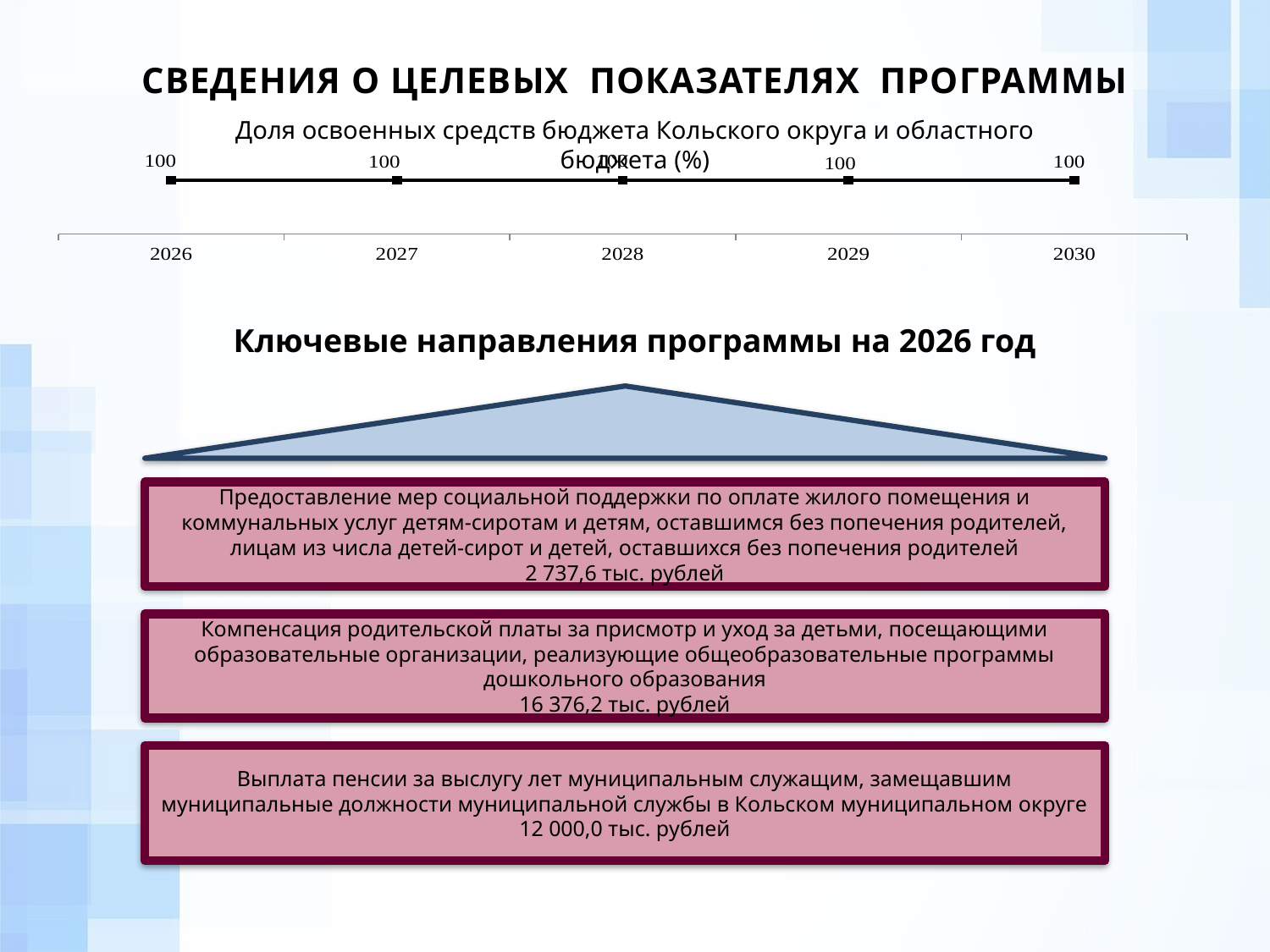
What is the value for 2026 in the chart "Доля освоенных средств бюджета Кольского округа и областного бюджета (%)"? 100 What is the value for 2030 in the chart? 100 What kind of chart is shown on the slide? line chart Do the values in the chart rise, fall, or stay the same from 2026 to 2030? stay the same What is the first year shown on the x axis of the chart? 2026 What is the value for 2028 in the chart? 100 What is the value for 2027 in the chart? 100 How many years (data points) are plotted in the chart? 5 What is the difference between the values for 2026 and 2030 in the chart? 0 What is the title of the chart on the slide? Доля освоенных средств бюджета Кольского округа и областного бюджета (%)